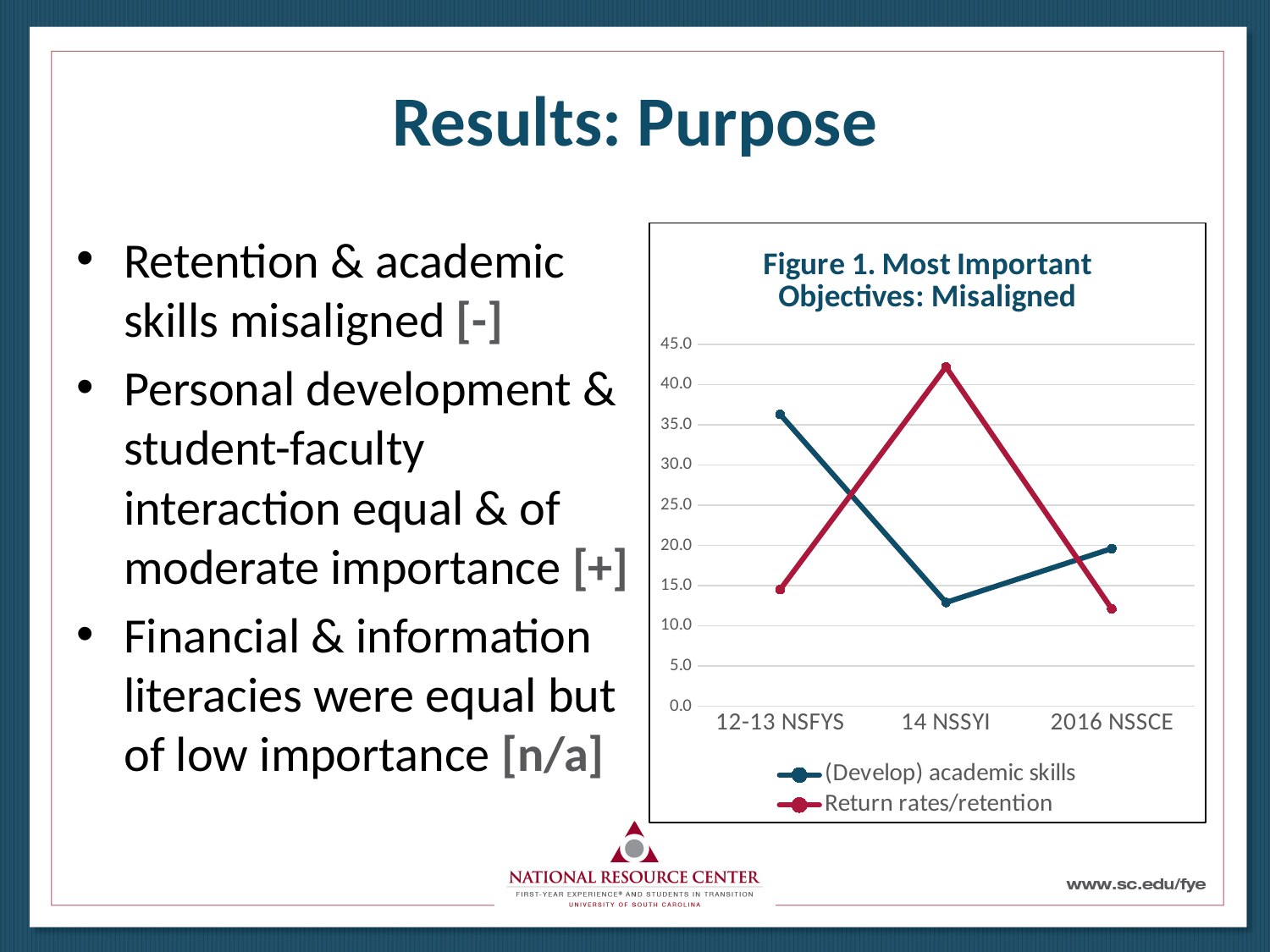
In Figure 1, at which survey is the (Develop) academic skills value highest? 12-13 NSFYS In Figure 1, is the Return rates/retention value at 14 NSSYI greater or less than 40.0? greater In Figure 1, is the (Develop) academic skills value at 14 NSSYI greater or less than 15.0? less What kind of chart is shown in Figure 1? line chart What is the title of the chart on the slide? Figure 1. Most Important Objectives: Misaligned How many series does the legend of Figure 1 list? 2 In Figure 1, at which survey is the Return rates/retention value highest? 14 NSSYI In Figure 1, at which survey is the (Develop) academic skills value lowest? 14 NSSYI In Figure 1, which series has the larger value at 14 NSSYI? Return rates/retention In Figure 1, does the Return rates/retention line rise or fall from 14 NSSYI to 2016 NSSCE? fall In Figure 1, which series has the larger value at 12-13 NSFYS? (Develop) academic skills How many categories are shown on the x axis of Figure 1? 3